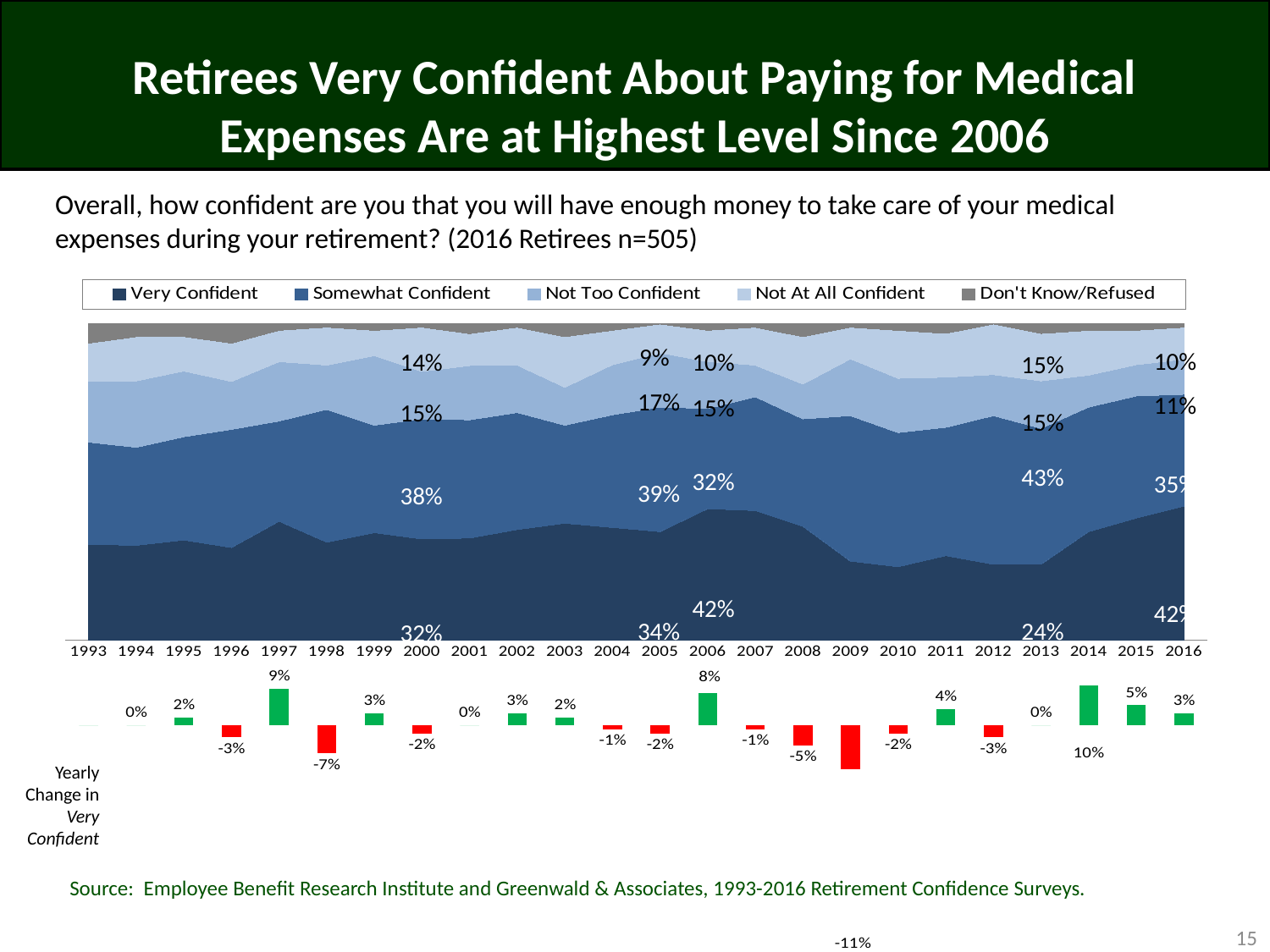
In the bottom bar chart, which year has the highest yearly change in Very Confident? 2014 In the bottom bar chart, which year has the lowest yearly change in Very Confident? 2009 In the bottom bar chart, what is the yearly change in Very Confident for 1997? 9% In the bottom bar chart, what is the yearly change in Very Confident for 2008? -5% In the top stacked area chart, which was larger in 2000: Very Confident or Somewhat Confident? Somewhat Confident In the top stacked area chart, what percentage of retirees were Somewhat Confident in 2013? 43% How many series does the legend of the top stacked area chart list? 5 What kind of chart is the bottom chart showing Yearly Change in Very Confident? Bar chart In the top stacked area chart, what percentage of retirees were Very Confident in 2006? 42% In the top stacked area chart, what percentage of retirees were Not At All Confident in 2005? 9% In the top stacked area chart, what is the difference between the Very Confident share in 2016 and in 2013? 18% In the top stacked area chart, what is the first year shown on the x axis? 1993